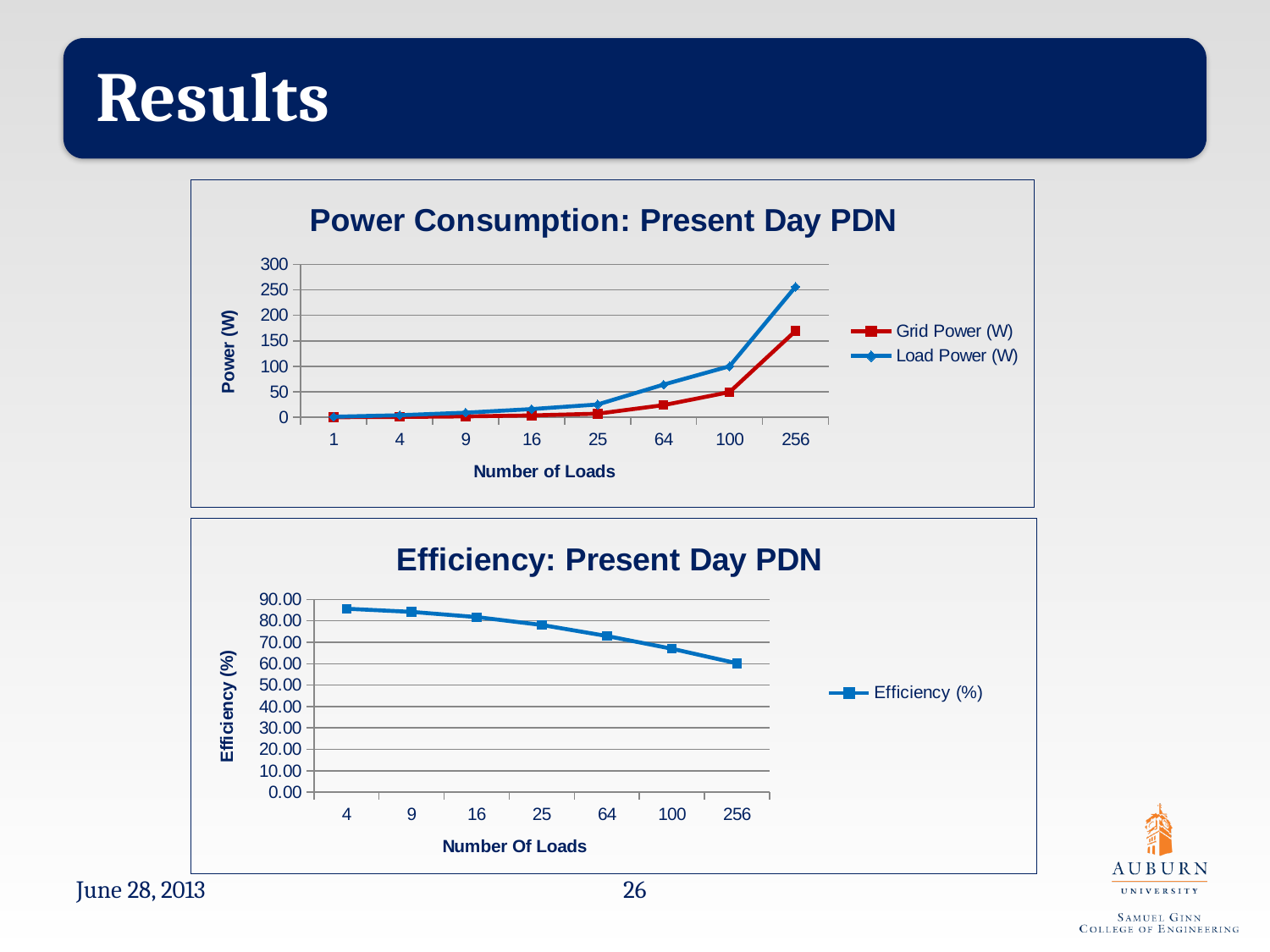
In the "Efficiency: Present Day PDN" chart, is the efficiency at 100 loads greater or less than 70.00? less In the "Power Consumption: Present Day PDN" chart, is the Load Power (W) value at 256 loads greater or less than 200? greater In the "Power Consumption: Present Day PDN" chart, which series is higher at 256 loads, Grid Power (W) or Load Power (W)? Load Power (W) How many Number of Loads categories are shown on the x axis of the "Power Consumption: Present Day PDN" chart? 8 How many series does the legend of the "Power Consumption: Present Day PDN" chart list? 2 In the "Efficiency: Present Day PDN" chart, at which number of loads is efficiency highest? 4 How many series does the legend of the "Efficiency: Present Day PDN" chart list? 1 In the "Power Consumption: Present Day PDN" chart, is the Grid Power (W) value at 64 loads greater or less than 50? less In the "Efficiency: Present Day PDN" chart, at which number of loads is efficiency lowest? 256 In the "Power Consumption: Present Day PDN" chart, do the power values rise or fall as the number of loads increases? rise What kind of chart is the "Power Consumption: Present Day PDN" chart? line chart